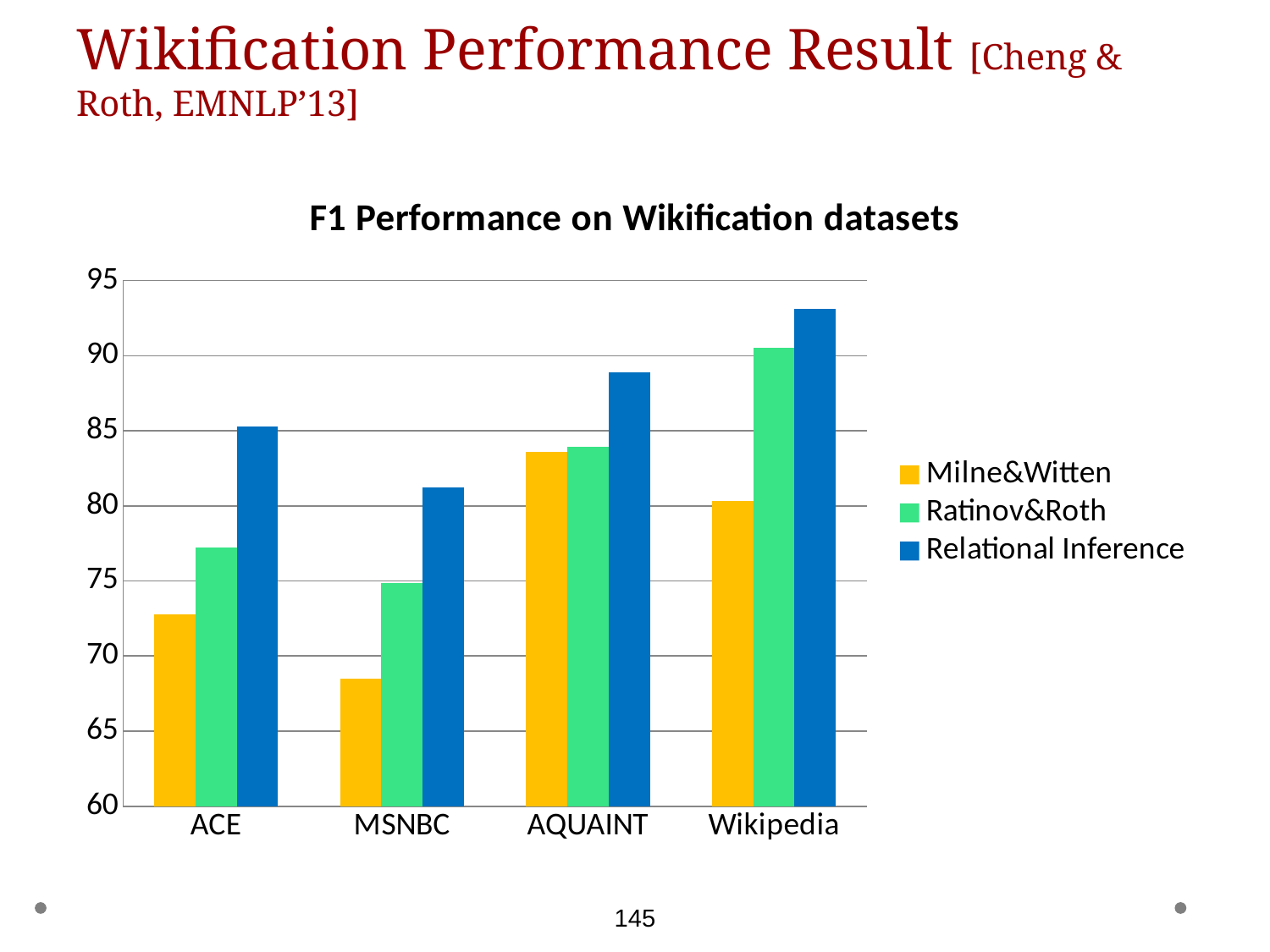
Is the Relational Inference value for Wikipedia greater or less than 90? greater How many datasets are shown on the x axis? 4 What type of chart is shown on the slide? bar chart How many series does the legend list? 3 Is the Ratinov&Roth value for ACE greater or less than 75? greater Which dataset has the lowest Milne&Witten bar? MSNBC Which is larger: the Ratinov&Roth value for Wikipedia or the Relational Inference value for ACE? Ratinov&Roth value for Wikipedia Which dataset has the highest Relational Inference bar? Wikipedia What is the title of the chart? F1 Performance on Wikification datasets Is the Milne&Witten value for MSNBC greater or less than 70? less Which series is shown in blue in the legend? Relational Inference